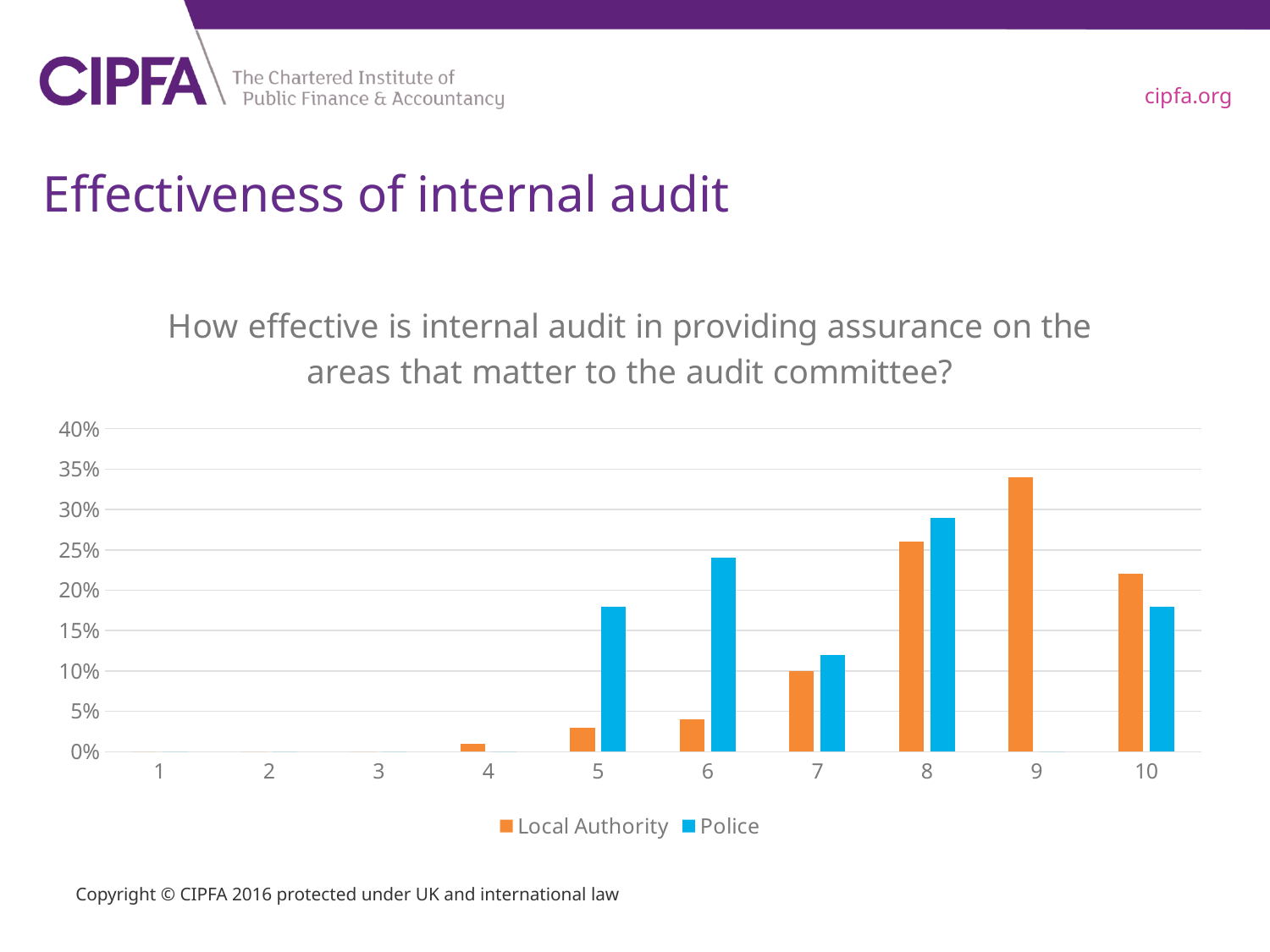
Is the Police value for rating 8 greater or less than 30%? less At rating 10, which series has the larger value, Local Authority or Police? Local Authority Is the Police value for rating 6 greater or less than 20%? greater Which rating has the highest value for Local Authority? 9 How many series does the legend list? 2 Which colour represents the Police series in the chart? blue How many rating categories are shown on the x axis? 10 Which rating has the highest value for Police? 8 What kind of chart is shown on the slide? bar chart Is the Local Authority value for rating 9 greater or less than 30%? greater At rating 8, which series has the larger value, Local Authority or Police? Police